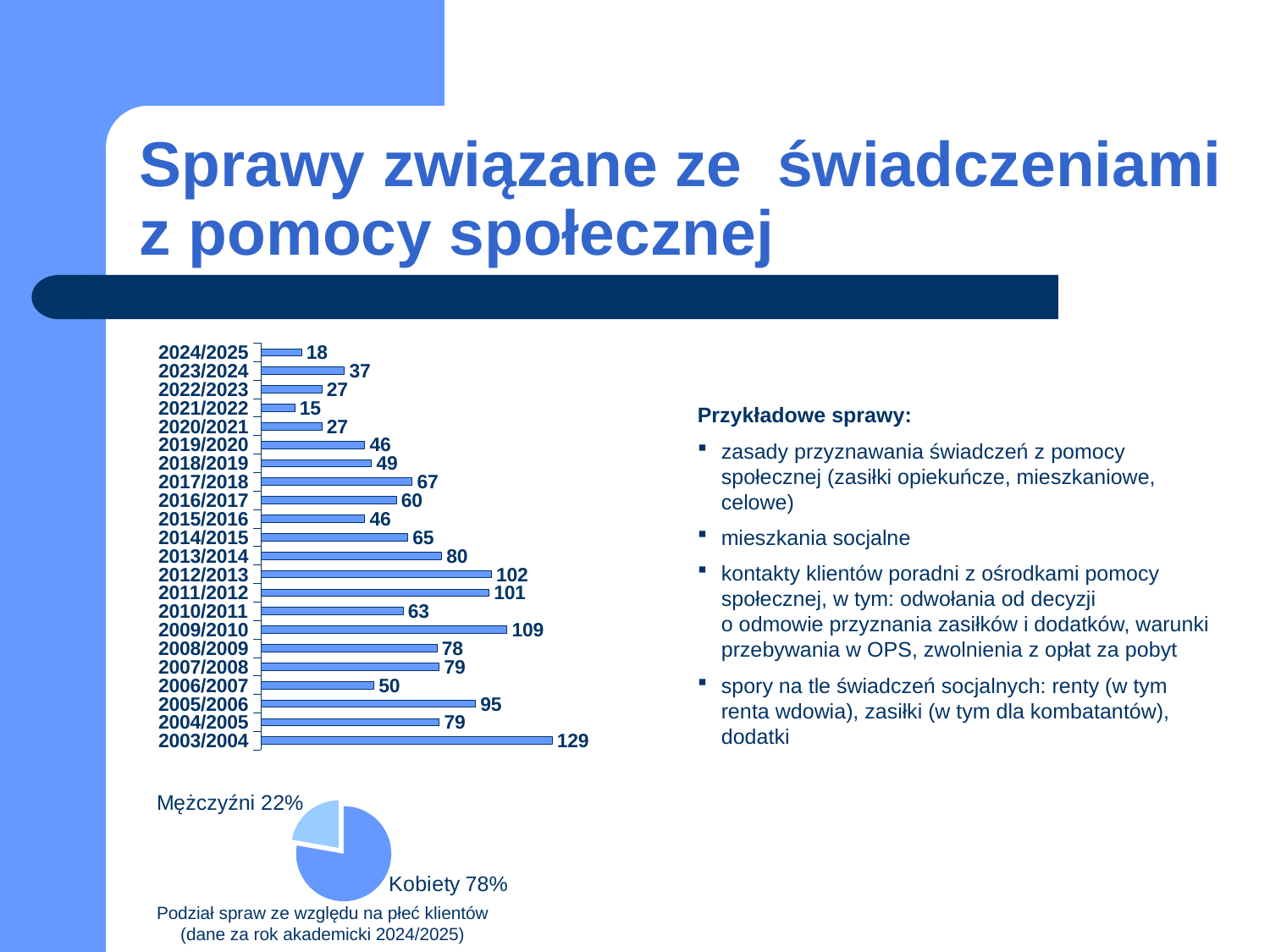
In the pie chart, what share is labelled Kobiety? 78% In the bar chart, which year has the highest value? 2003/2004 In the bar chart, what is the value for 2009/2010? 109 In the bar chart, which year has the lowest value? 2021/2022 In the bar chart, what is the difference between the values for 2012/2013 and 2011/2012? 1 How many years (categories) are shown in the bar chart? 22 What kind of chart is the chart at the top left of the slide? bar chart In the bar chart, what is the value for 2024/2025? 18 In the bar chart, which is larger, the value for 2017/2018 or the value for 2016/2017? 2017/2018 In the pie chart, what share is labelled Mężczyźni? 22% In the bar chart, what is the value for 2003/2004? 129 In the bar chart, what is the difference between the values for 2003/2004 and 2024/2025? 111